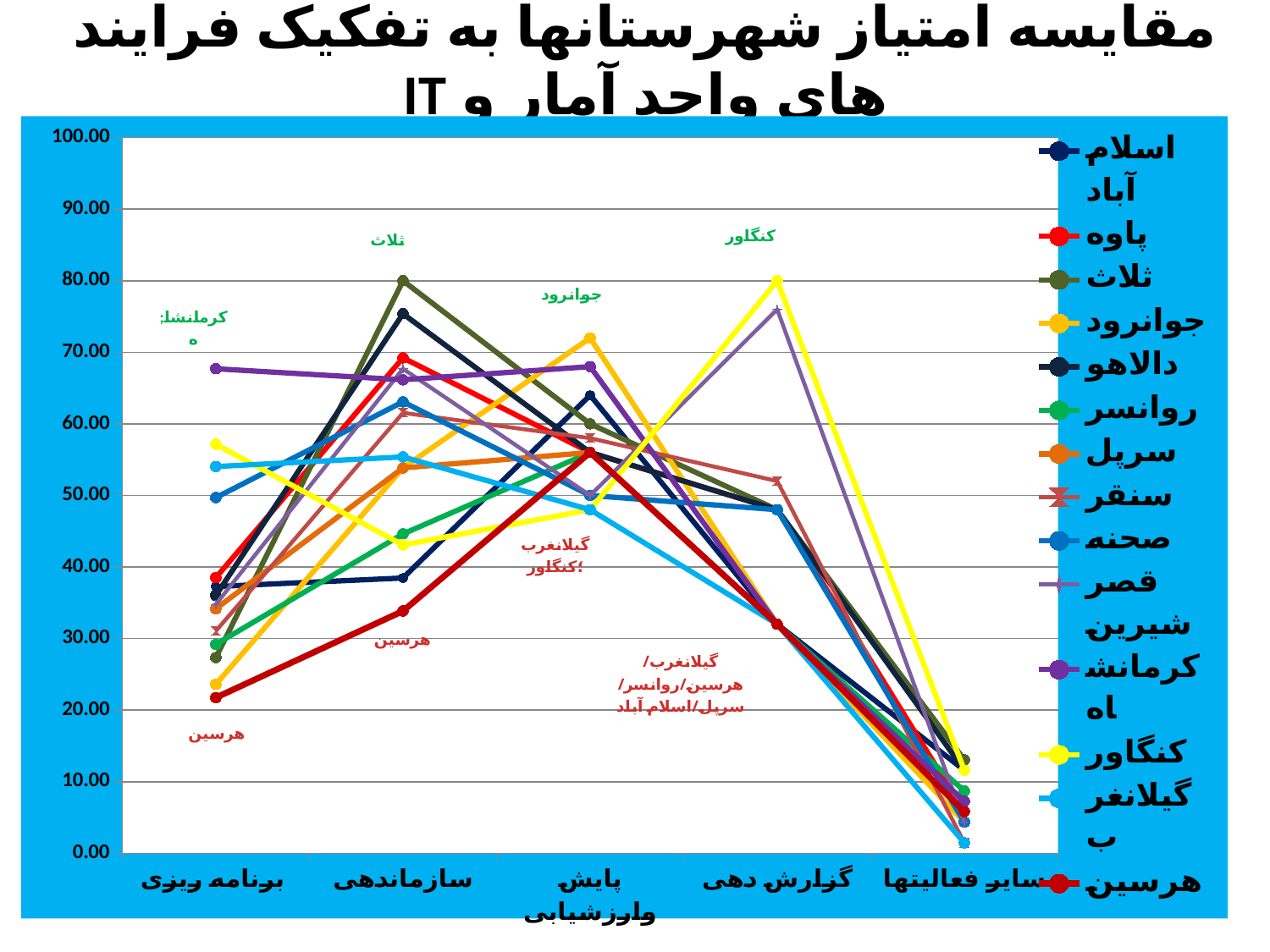
Which series has the lowest value at برنامه ریزی? هرسین Is the value for هرسین at برنامه ریزی greater or less than 30? less How many series does the legend list? 14 Which series has the highest value at پایش و ارزشیابی? جوانرود Does the value for کنگاور rise or fall from گزارش دهی to سایر فعالیتها? fall Is the value for کنگاور at گزارش دهی greater or less than 70? greater Which series has the highest value at گزارش دهی? کنگاور Which series has the highest value at سازماندهی? ثلاث At برنامه ریزی, which is larger: the value for کرمانشاه or the value for هرسین? کرمانشاه How many categories are shown along the x axis? 5 Is the value for ثلاث at سازماندهی greater or less than 70? greater What kind of chart is shown on the slide? line chart